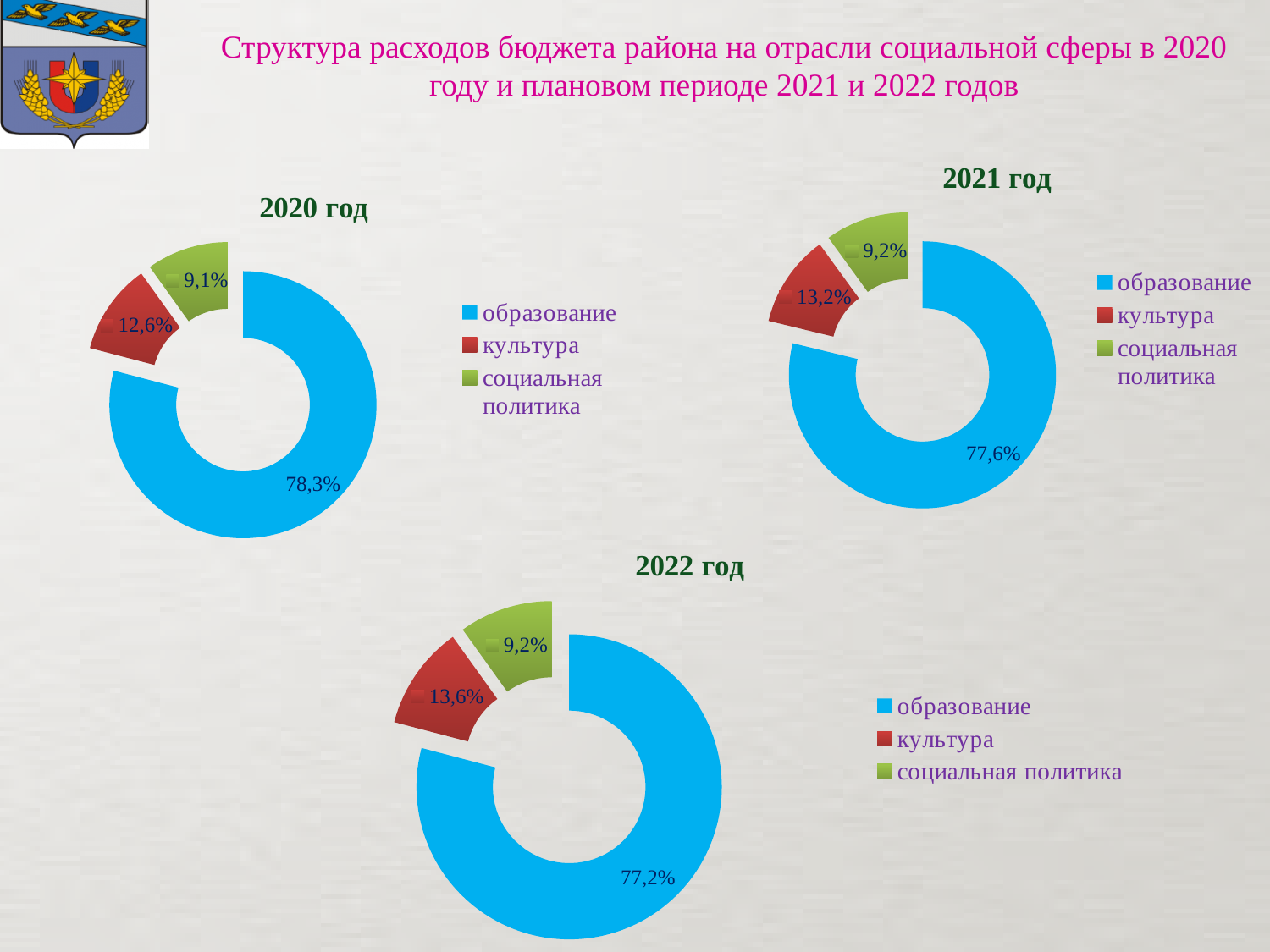
How many categories does the "2021 год" chart show? 3 In the "2020 год" chart, which category has the smallest share? социальная политика In the "2022 год" chart, what share is shown for социальная политика? 9,2% In the "2021 год" chart, what share is shown for культура? 13,2% What type of chart is the "2022 год" chart? doughnut chart In the "2020 год" chart, what colour represents образование? blue In the "2020 год" chart, what share is shown for образование? 78,3% In the "2021 год" chart, what is the difference between the shares of образование and культура? 64,4% In the "2022 год" chart, what is the difference between the shares of культура and социальная политика? 4,4% In the "2022 год" chart, which category has the largest share? образование In the "2020 год" chart, which is larger: the share of культура or the share of социальная политика? культура How many charts are on the slide? 3